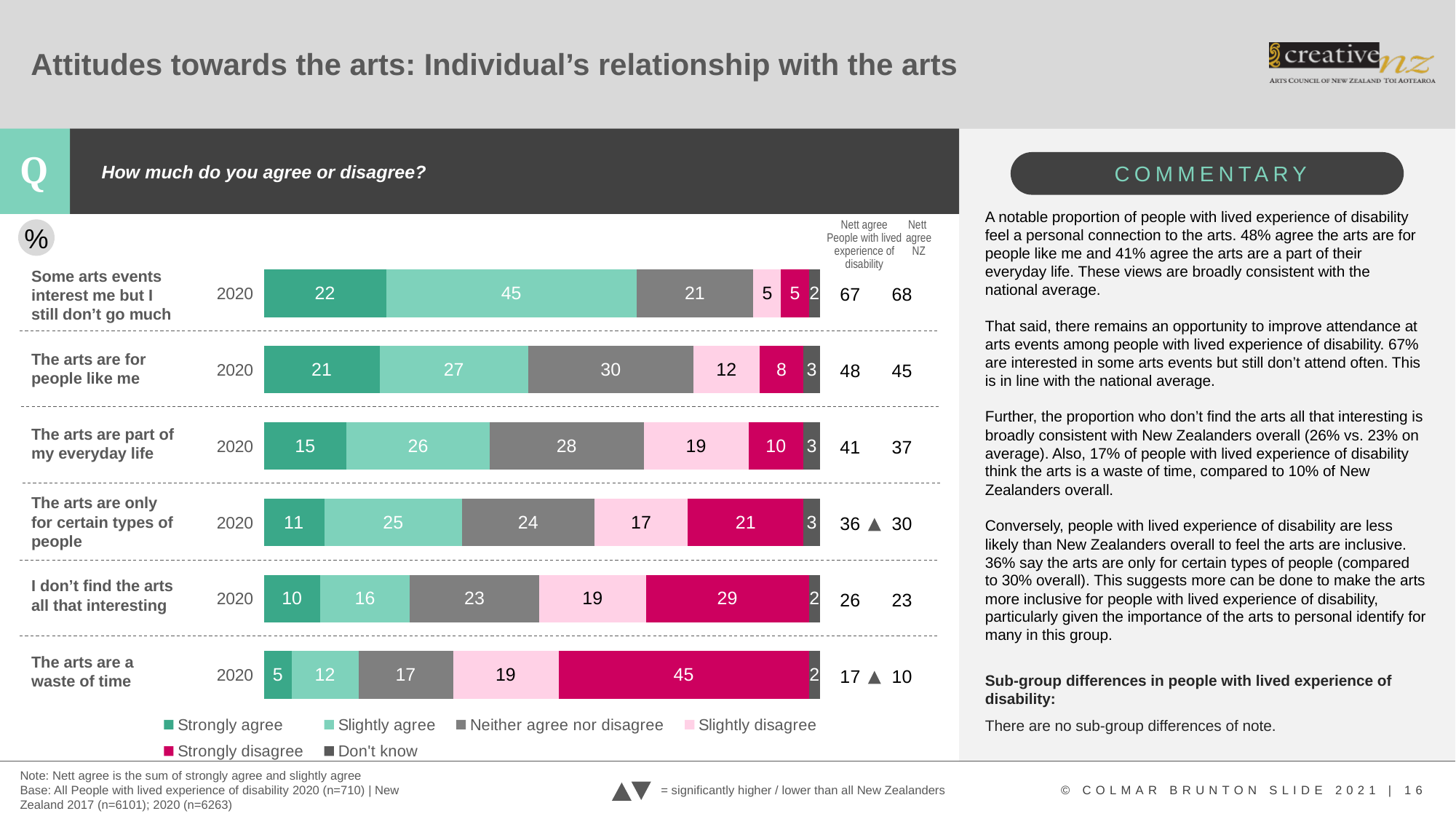
Which statement has the lowest 'Strongly agree' value? The arts are a waste of time What is the difference between the 'Neither agree nor disagree' values for 'The arts are for people like me' and 'The arts are a waste of time'? 13 Which statement has the highest 'Strongly disagree' value? The arts are a waste of time What is the total of 'Strongly agree' and 'Slightly agree' for 'The arts are only for certain types of people'? 36 Which is larger: the 'Slightly disagree' value for 'The arts are part of my everyday life' or for 'The arts are for people like me'? The arts are part of my everyday life What percentage strongly agree that the arts are a waste of time? 5 What kind of chart is shown on the slide? Stacked bar chart How many statements are shown in the chart? 6 What colour represents 'Strongly disagree' in the chart? Magenta/dark pink What percentage strongly disagree that the arts are only for certain types of people? 21 How many series does the legend list? 6 What percentage slightly agree with the statement 'Some arts events interest me but I still don't go much'? 45